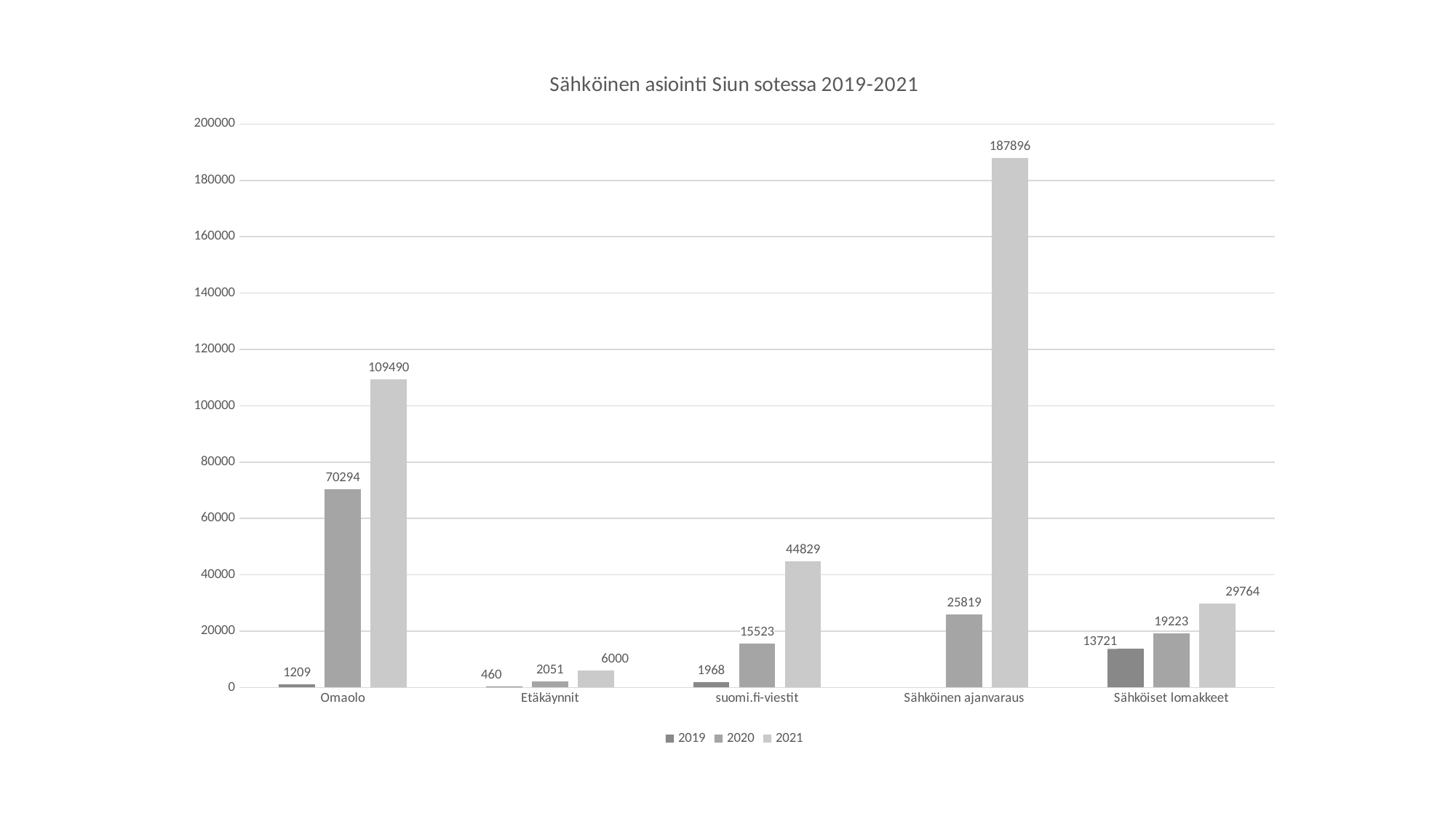
Is the 2021 value for Sähköiset lomakkeet greater or less than 40000? less What is the value for Etäkäynnit in 2019? 460 What is the title of the chart? Sähköinen asiointi Siun sotessa 2019-2021 Which is larger: the 2020 value for Omaolo or the 2021 value for suomi.fi-viestit? 2020 value for Omaolo What is the difference between the 2021 and 2020 values for suomi.fi-viestit? 29306 What is the value for Omaolo in 2021? 109490 What kind of chart is shown on the slide? bar chart Which category has the lowest value in 2020? Etäkäynnit How many series does the legend list? 3 Which category has the highest value in 2021? Sähköinen ajanvaraus How many categories are shown on the x axis? 5 What is the value for Sähköinen ajanvaraus in 2020? 25819